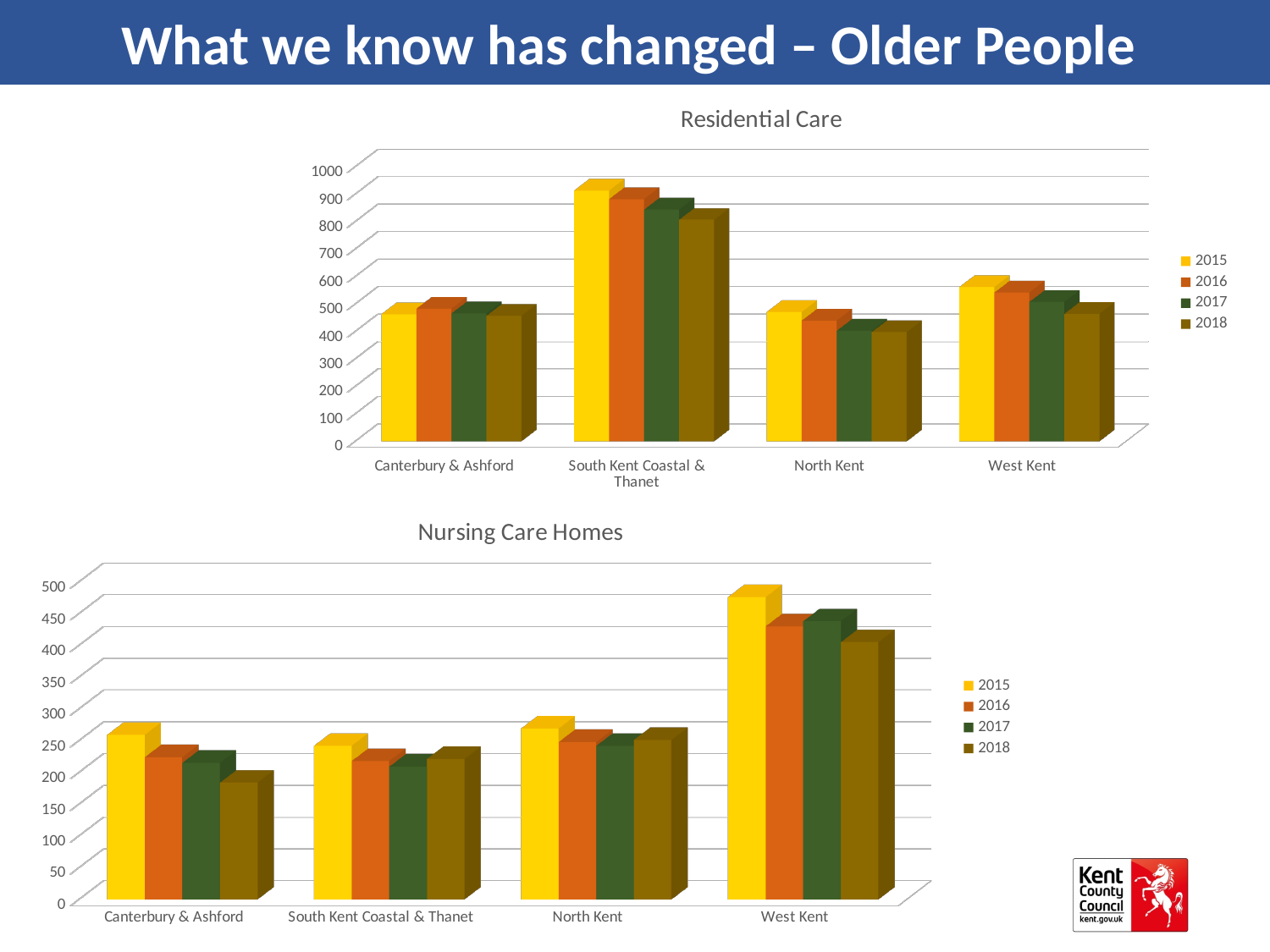
In the Residential Care chart, which area has the highest value for 2015? South Kent Coastal & Thanet In the Nursing Care Homes chart, which area has the highest value for 2018? West Kent In the Residential Care chart, do the values for South Kent Coastal & Thanet rise or fall from 2015 to 2018? Fall How many series does the legend of the Nursing Care Homes chart list? 4 In the Nursing Care Homes chart, is the 2015 value for West Kent greater or less than 400? greater In the Residential Care chart, is the 2015 value for South Kent Coastal & Thanet greater or less than 800? greater In the Residential Care chart, which is larger for 2015: West Kent or North Kent? West Kent What kind of chart is the Residential Care chart? Bar chart What are the legend entries of the Residential Care chart? 2015, 2016, 2017, 2018 In the Nursing Care Homes chart, do the values for Canterbury & Ashford rise or fall from 2015 to 2018? Fall How many area categories are shown on the x axis of the Residential Care chart? 4 In the Nursing Care Homes chart, is the 2018 value for Canterbury & Ashford greater or less than 250? less